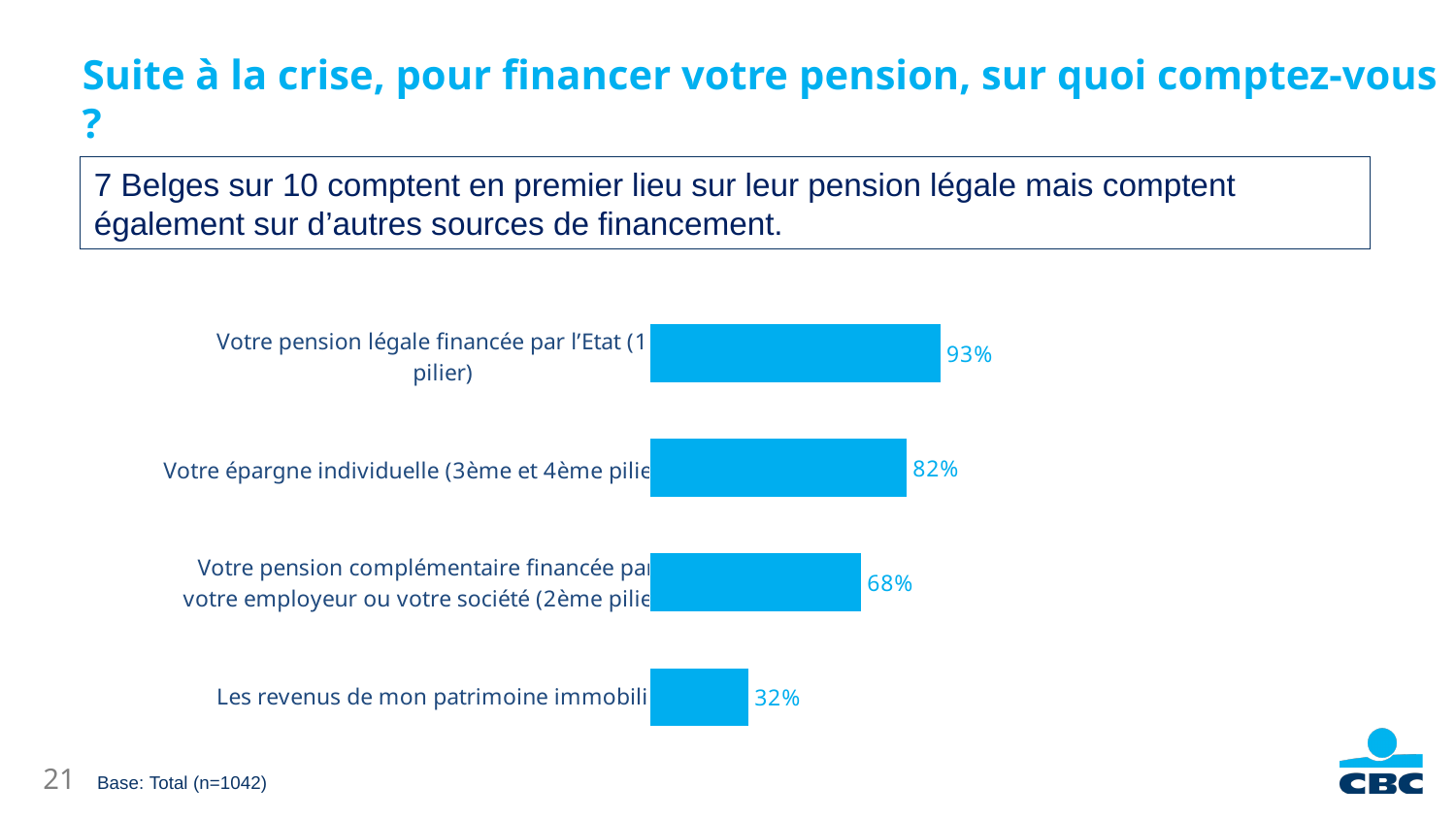
What is the value for "Votre pension complémentaire financée par votre employeur ou votre société (2ème pilier)"? 68% Which category has the lowest value? Les revenus de mon patrimoine immobilier What is the value for "Votre épargne individuelle (3ème et 4ème pilier)"? 82% What is the base (sample size) stated for the chart? Total (n=1042) What is the difference between the value for "Votre pension légale financée par l'Etat (1 pilier)" and the value for "Votre épargne individuelle (3ème et 4ème pilier)"? 11% What is the difference between the value for "Votre pension complémentaire financée par votre employeur ou votre société (2ème pilier)" and the value for "Les revenus de mon patrimoine immobilier"? 36% Which category has the highest value? Votre pension légale financée par l'Etat (1 pilier) What is the value for "Les revenus de mon patrimoine immobilier"? 32% Which is larger: the value for "Votre épargne individuelle (3ème et 4ème pilier)" or the value for "Votre pension complémentaire financée par votre employeur ou votre société (2ème pilier)"? Votre épargne individuelle (3ème et 4ème pilier) What kind of chart is shown on the slide? Bar chart What is the value for "Votre pension légale financée par l'Etat (1 pilier)"? 93% How many categories are shown in the chart? 4